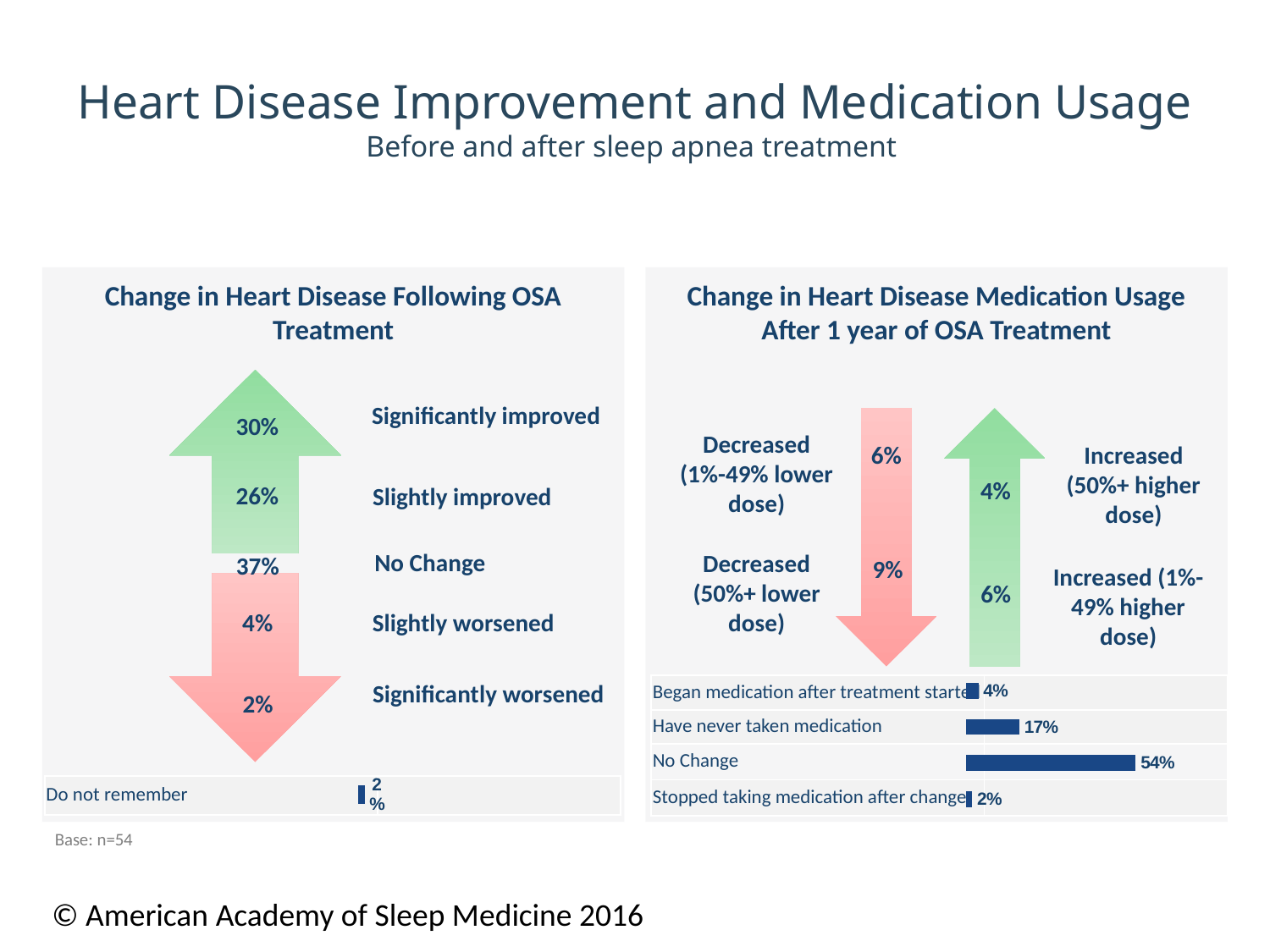
In the 'Change in Heart Disease Medication Usage After 1 year of OSA Treatment' chart, what percentage is shown for 'No Change'? 54% In the 'Change in Heart Disease Following OSA Treatment' chart, what percentage reported 'Significantly improved'? 30% In the 'Change in Heart Disease Following OSA Treatment' chart, which category has the highest percentage? No Change In the 'Change in Heart Disease Medication Usage After 1 year of OSA Treatment' chart, what percentage is shown for 'Have never taken medication'? 17% In the 'Change in Heart Disease Following OSA Treatment' chart, what is the difference between 'Significantly improved' and 'Slightly improved'? 4% In the 'Change in Heart Disease Following OSA Treatment' chart, which is larger: 'Slightly worsened' or 'Significantly worsened'? Slightly worsened What kind of chart is used for the 'No Change' and 'Have never taken medication' values on the right-hand panel? Bar chart In the 'Change in Heart Disease Medication Usage After 1 year of OSA Treatment' chart, which of the four bar categories has the lowest percentage? Stopped taking medication after change In the 'Change in Heart Disease Following OSA Treatment' chart, what percentage reported 'No Change'? 37% How many bar categories are listed below the arrows in the 'Change in Heart Disease Medication Usage After 1 year of OSA Treatment' chart? 4 In the 'Change in Heart Disease Medication Usage After 1 year of OSA Treatment' chart, what percentage is shown for 'Decreased (50%+ lower dose)'? 9% In the 'Change in Heart Disease Medication Usage After 1 year of OSA Treatment' chart, what is the difference between 'No Change' and 'Have never taken medication'? 37%